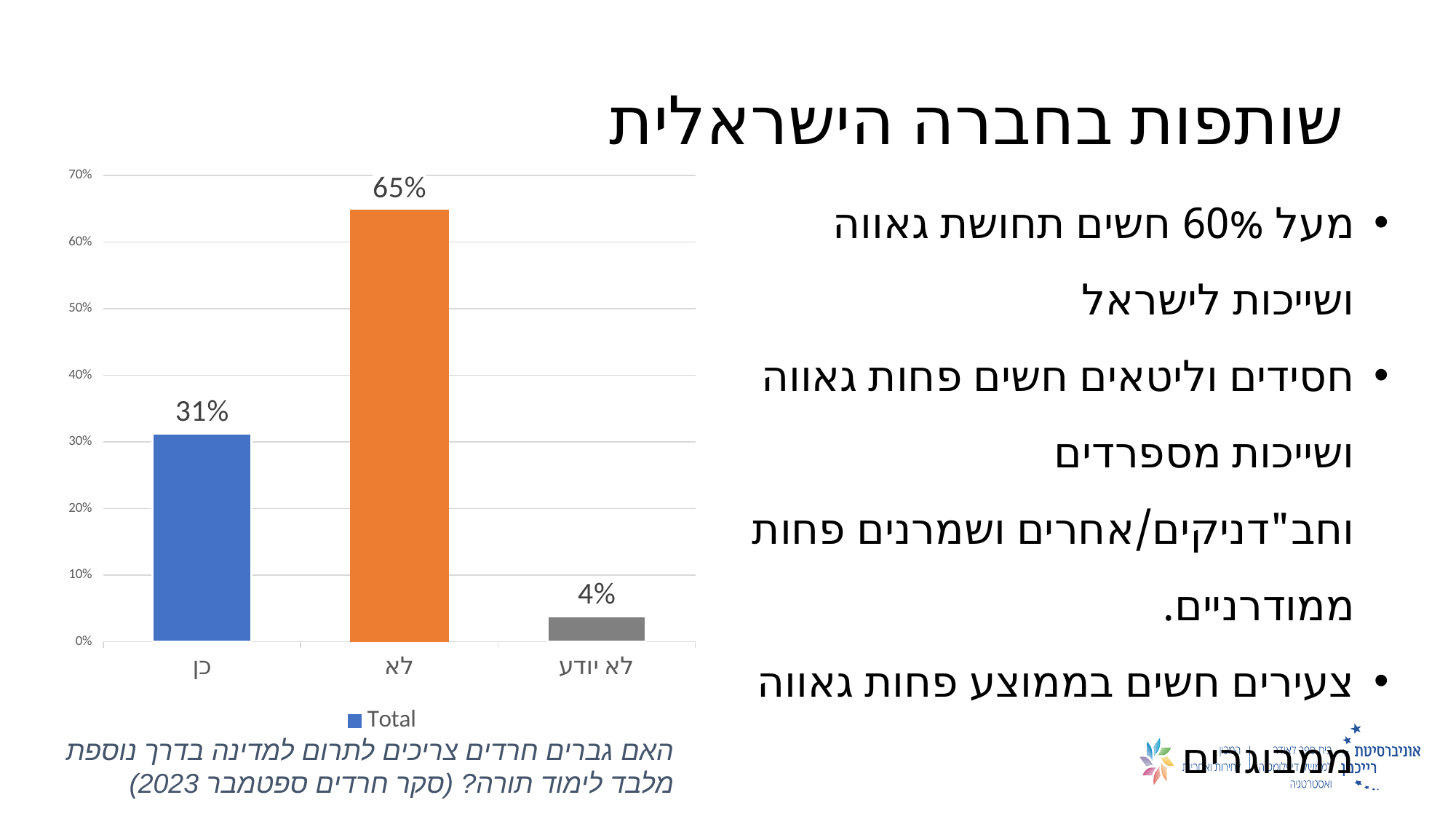
What is the value for the category "לא יודע"? 4% Which is larger, the value for "כן" or the value for "לא יודע"? כן What is the value for the category "כן"? 31% What kind of chart is shown on the slide? bar chart How many categories are shown on the x axis? 3 What is the difference between the values for "לא" and "כן"? 34% What is the value for the category "לא"? 65% Which category has the highest value? לא Which category has the lowest value? לא יודע How many series does the legend list? 1 What is the legend entry shown below the chart? Total Is the value for "לא" greater or less than 60%? greater